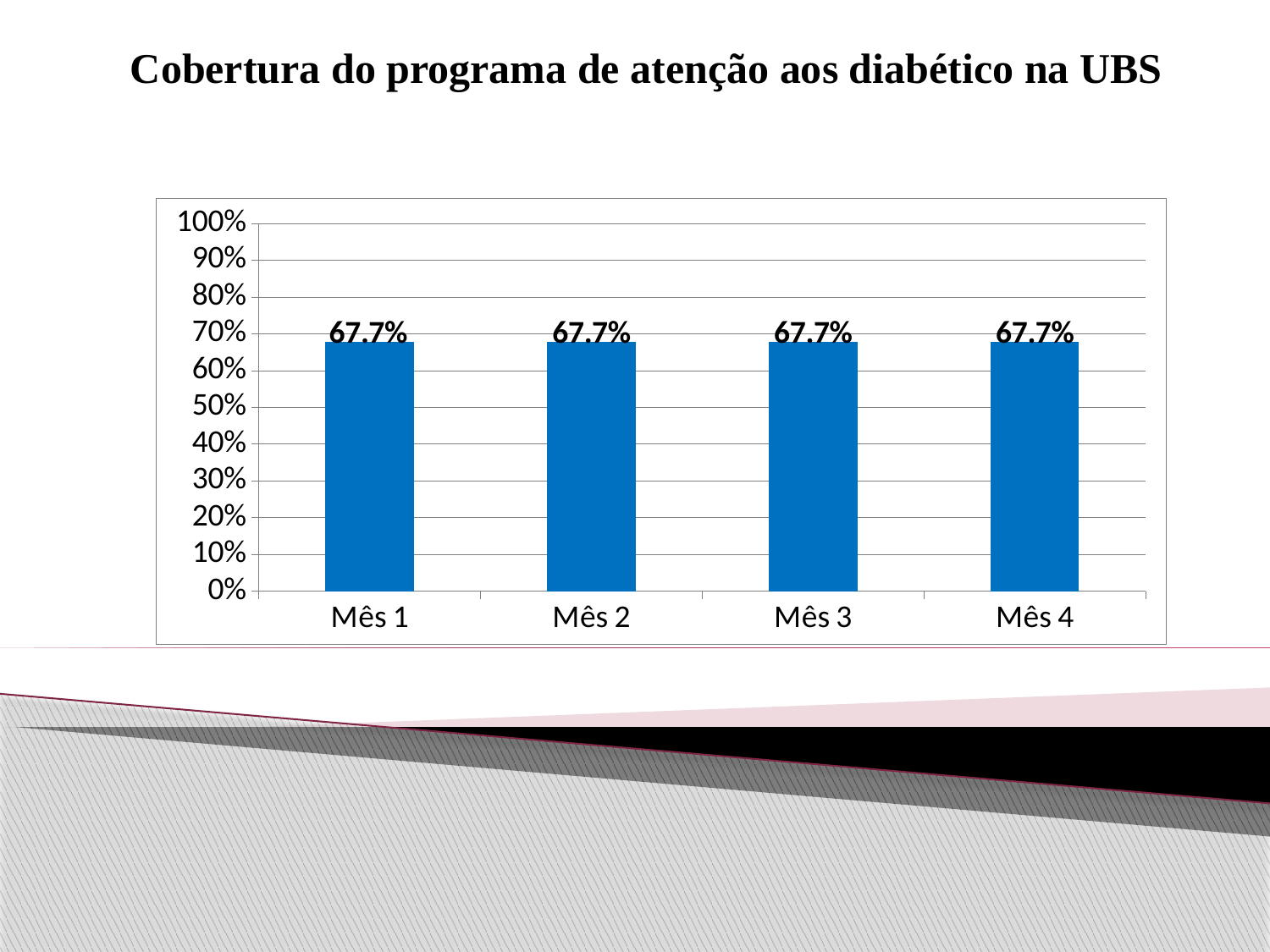
What is the value for Mês 3? 67.7% What is the value for Mês 4? 67.7% How many categories are shown on the x axis? 4 What colour are the bars in the chart? blue What is the value for Mês 1? 67.7% What is the difference between the values for Mês 2 and Mês 4? 0.0% What kind of chart is shown on the slide? bar chart What is the title of the slide? Cobertura do programa de atenção aos diabético na UBS Is the value for Mês 3 greater or less than 70%? less What is the highest value shown on the y axis? 100% Do the values rise, fall or stay the same from Mês 1 to Mês 4? stay the same Is the value for Mês 2 greater or less than 60%? greater